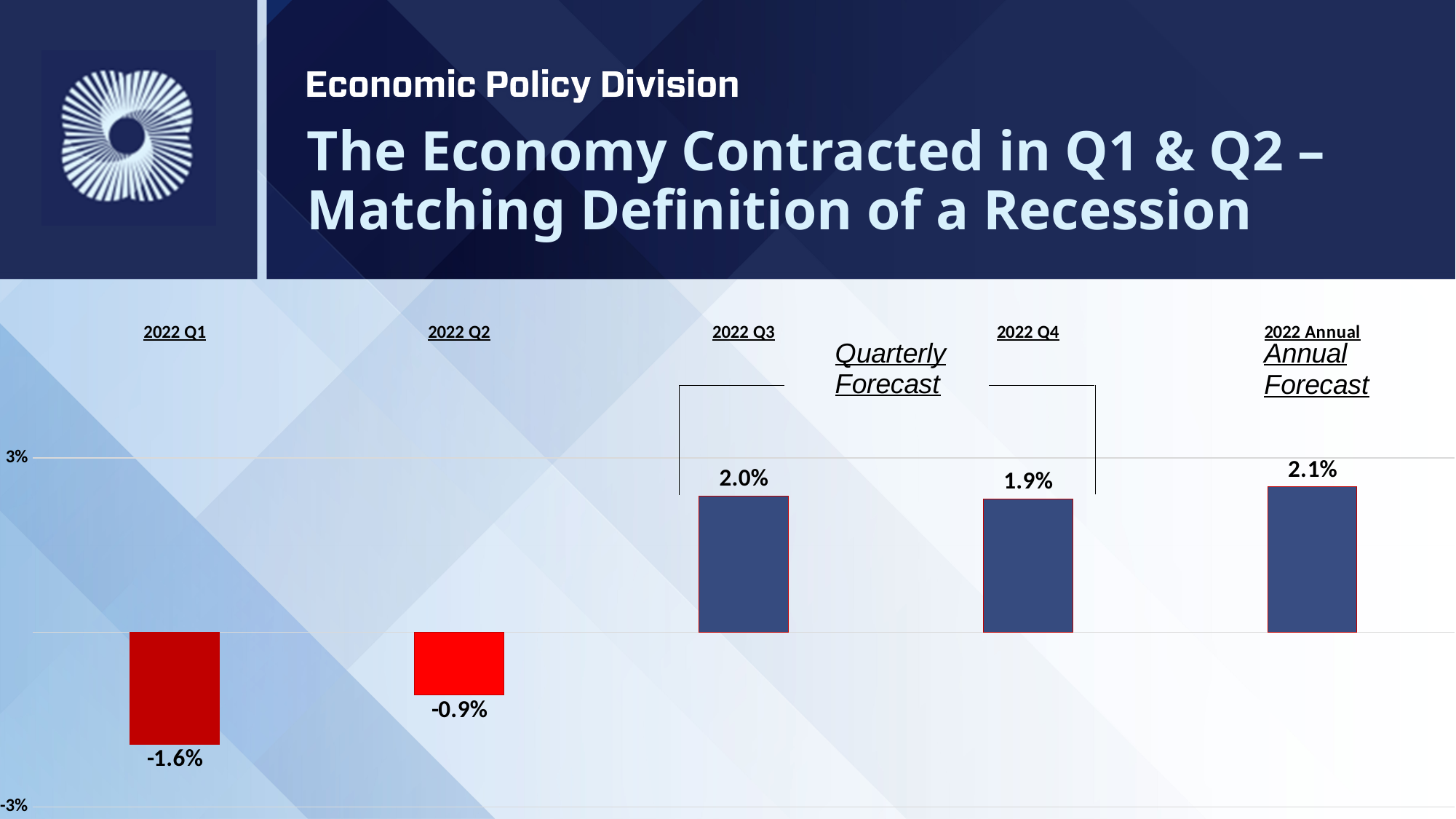
What is the value for 2022 Q4? 1.9% What is the value for 2022 Q1? -1.6% Which category has the highest value? 2022 Annual What is the value for 2022 Q2? -0.9% Which category has the lowest value? 2022 Q1 What is the value for 2022 Q3? 2.0% What kind of chart is shown on the slide? Bar chart What is the value for 2022 Annual? 2.1% What is the difference between the values for 2022 Q3 and 2022 Q4? 0.1% What colour are the bars for 2022 Q1 and 2022 Q2? Red Which is larger, the value for 2022 Q1 or 2022 Q2? 2022 Q2 How many bars are plotted in the chart? 5